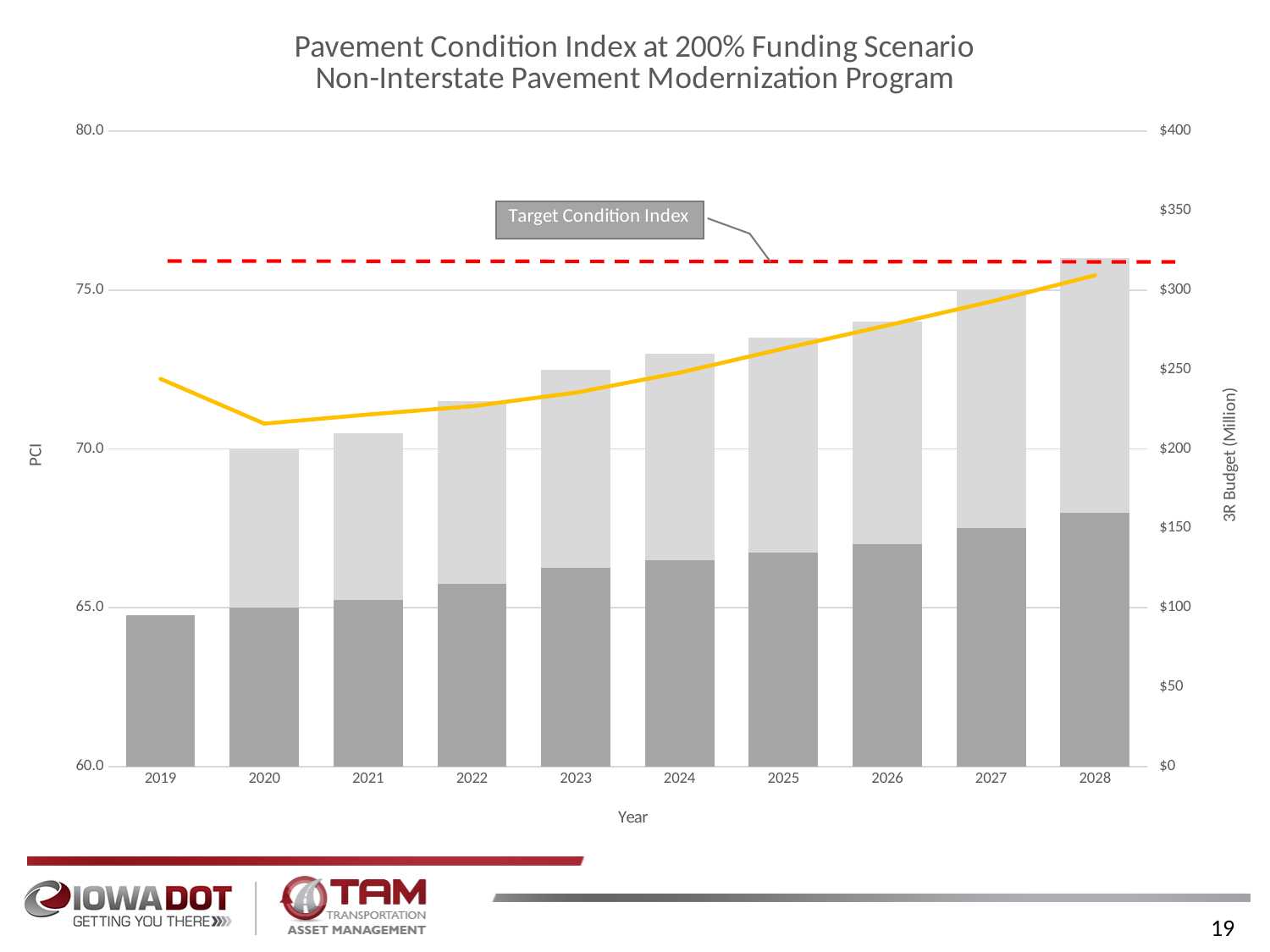
Which year has the tallest total bar? 2028 Is the dashed Target Condition Index line greater or less than 75.0 on the PCI axis? greater Which year has the shortest total bar? 2019 What is the title of the chart? Pavement Condition Index at 200% Funding Scenario Non-Interstate Pavement Modernization Program Is the yellow PCI line value for 2028 greater or less than 75.0? greater Is the total bar for 2027 larger or smaller than the total bar for 2021? larger Do the total bar heights rise or fall from 2019 to 2028? Rise Is the total bar for 2028 greater or less than $300 on the right axis? greater What label is shown on the right-hand vertical axis? 3R Budget (Million) How many years are shown along the x axis? 10 What kind of chart is this? Bar chart combined with a line chart